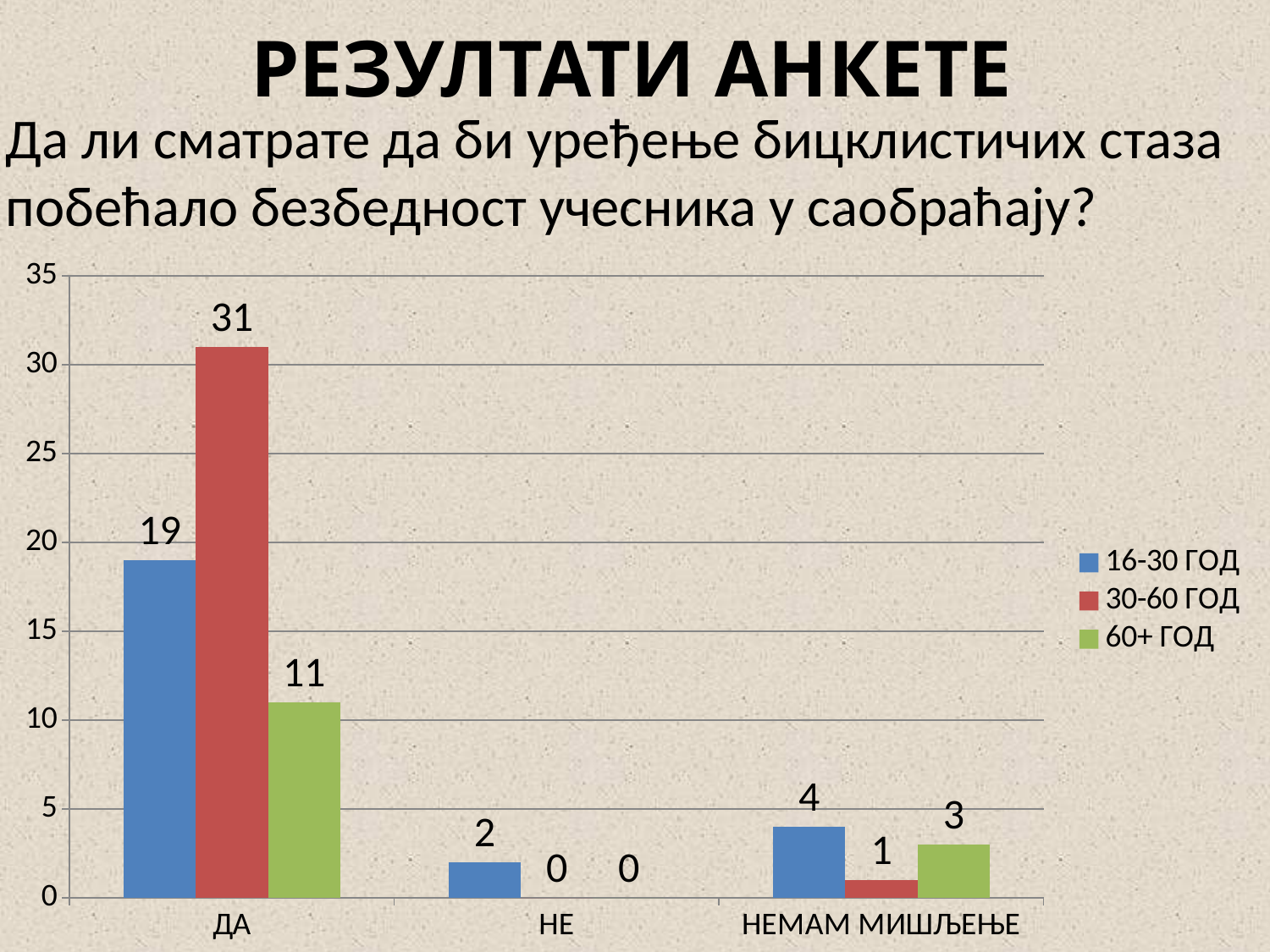
How many series does the legend list? 3 Which category has the highest value for the 30-60 ГОД series? ДА What is the difference between the 30-60 ГОД and 16-30 ГОД values in the ДА category? 12 What is the value for the 30-60 ГОД series in the ДА category? 31 What is the value for the 60+ ГОД series in the НЕМАМ МИШЉЕЊЕ category? 3 How many categories are shown on the x axis? 3 Which is larger in the НЕМАМ МИШЉЕЊЕ category: the 16-30 ГОД value or the 60+ ГОД value? 16-30 ГОД Which category has the lowest value for the 16-30 ГОД series? НЕ Is the value for the 60+ ГОД series in the ДА category greater or less than 10? greater What kind of chart is shown on the slide? bar chart What is the value for the 16-30 ГОД series in the ДА category? 19 What is the value for the 30-60 ГОД series in the НЕ category? 0